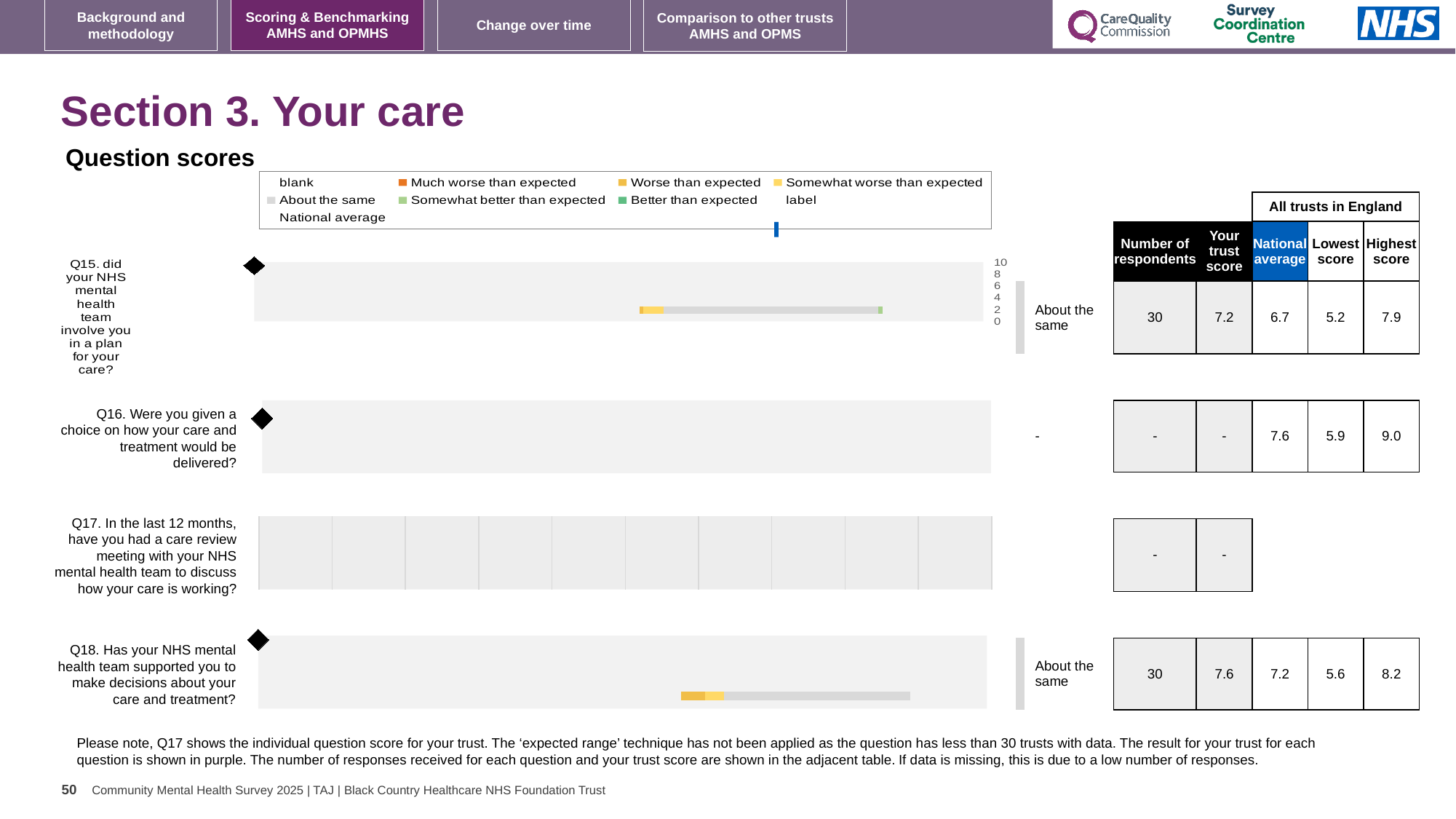
What is the highest score across all trusts in England for Q16? 9.0 What is the lowest score across all trusts in England for Q18? 5.6 What is the national average for Q15? 6.7 Which question has the higher trust score, Q15 or Q18? Q18 What is the trust score for Q15 shown in the table next to the chart? 7.2 What is the difference between the trust score and the national average for Q18? 0.4 How many respondents answered Q18? 30 What benchmark category label is shown for Q15 and Q18? About the same Which legend entry is shown in orange? Much worse than expected What kind of chart is used to show the question scores on this slide? bar chart How many questions (Q15 to Q18) are plotted in the question scores chart? 4 What is the difference between the highest and lowest scores for Q15? 2.7